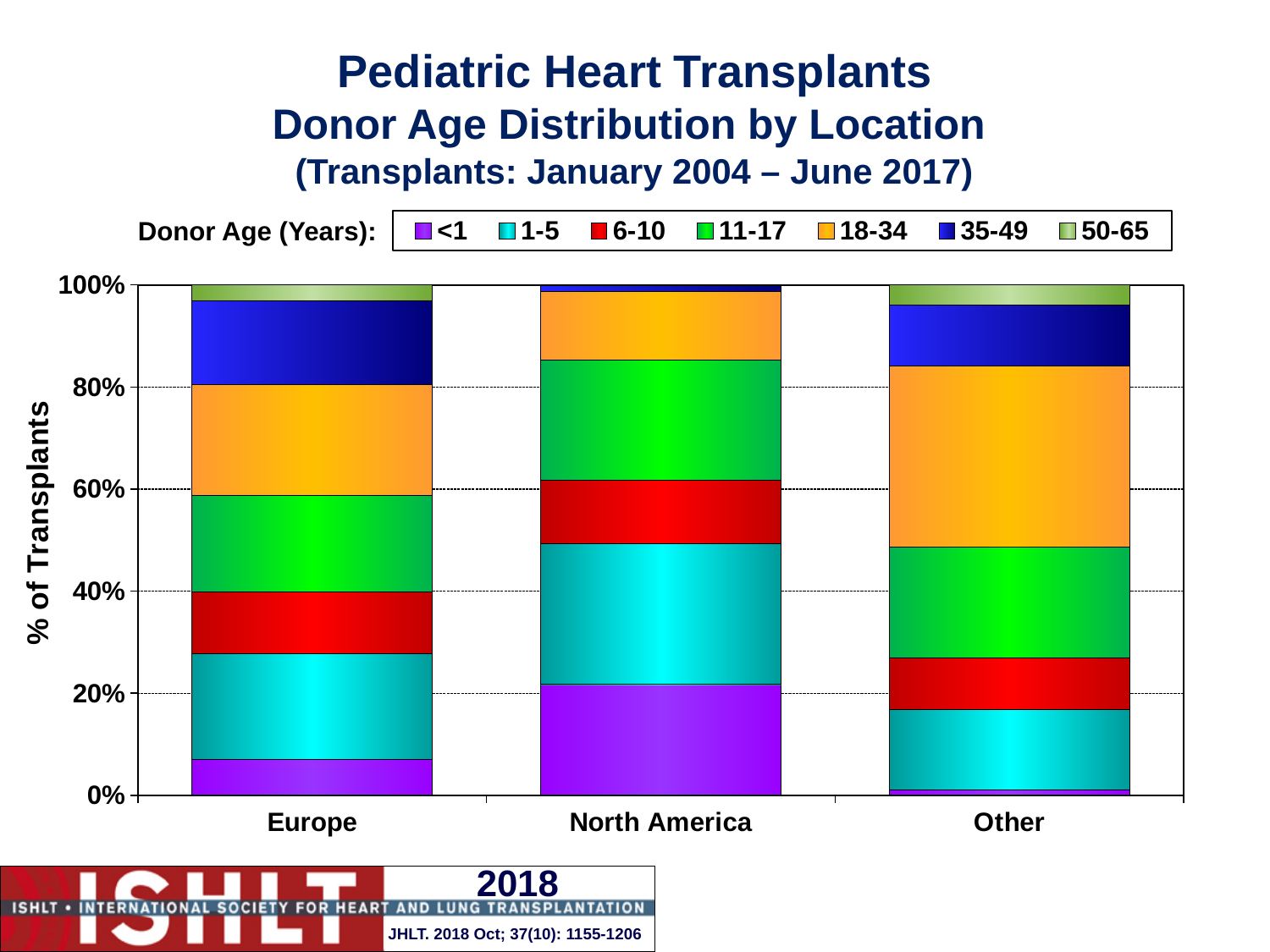
What does each stacked bar total? 100% Which location has the smallest share of donors aged 50-65? North America Which has a larger share of donors aged 35-49, Europe or North America? Europe How many locations are shown on the x axis? 3 Which location has the largest share of donors aged <1? North America What is the label on the y axis? % of Transplants How many donor age groups does the legend list? 7 Is the share of donors aged 6-10 for North America greater or less than 20%? less Which location has the largest share of donors aged 18-34? Other What transplant period is given in the chart title? January 2004 – June 2017 What kind of chart is shown on the slide? Stacked bar chart Is the share of donors aged <1 for North America greater or less than 20%? greater